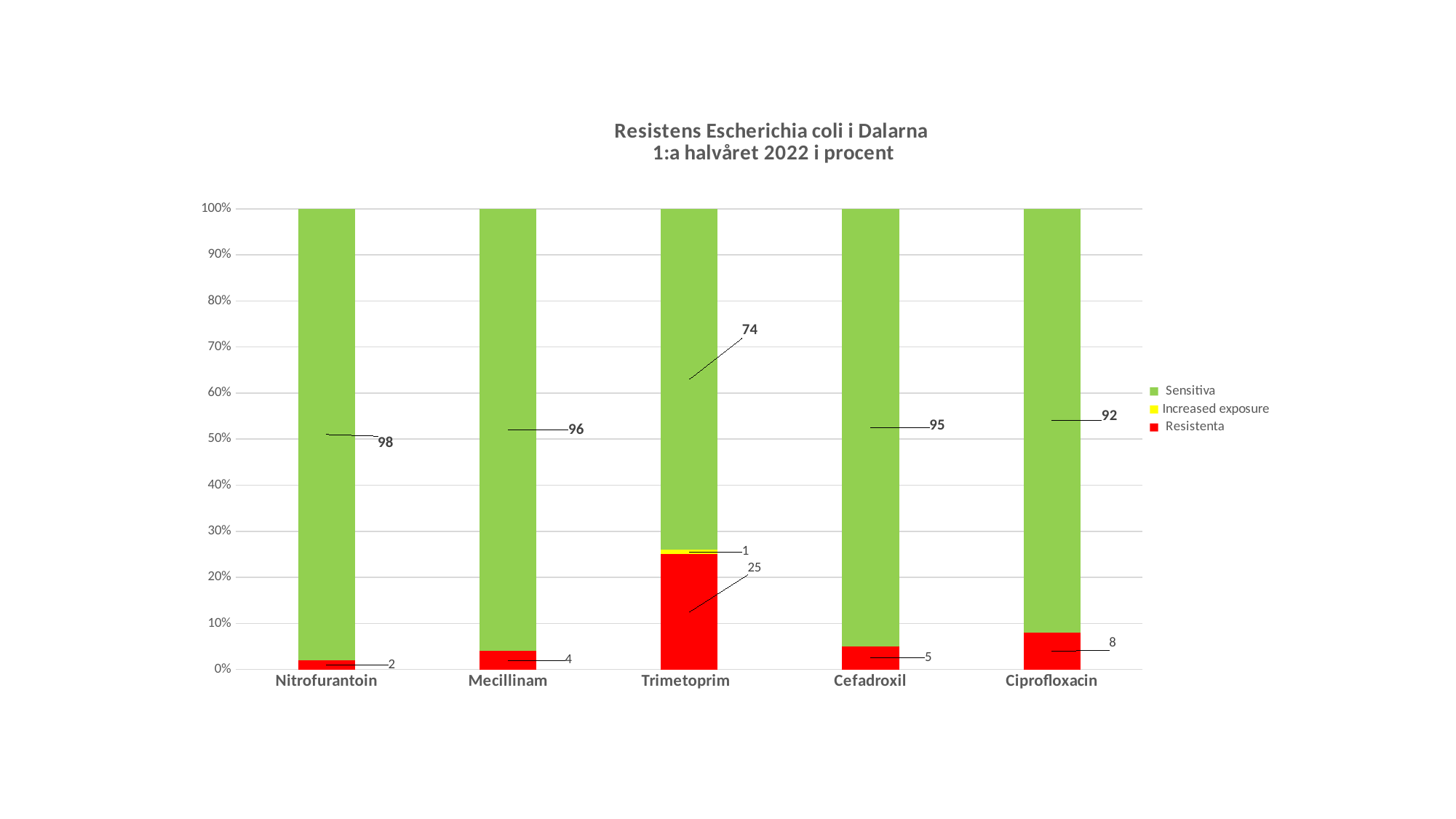
Which has a larger Resistenta value, Mecillinam or Cefadroxil? Cefadroxil What is the Resistenta value for Ciprofloxacin? 8 What is the Resistenta value for Trimetoprim? 25 Which antibiotic has the lowest Sensitiva value? Trimetoprim What is the Sensitiva value for Nitrofurantoin? 98 What is the difference between the Sensitiva values for Nitrofurantoin and Ciprofloxacin? 6 Which antibiotic has the highest Resistenta value? Trimetoprim What kind of chart is shown on the slide? Stacked bar chart What is the Increased exposure value for Trimetoprim? 1 What is the total of the stacked bar for Trimetoprim? 100 How many series does the legend list? 3 How many antibiotics are shown on the x axis? 5